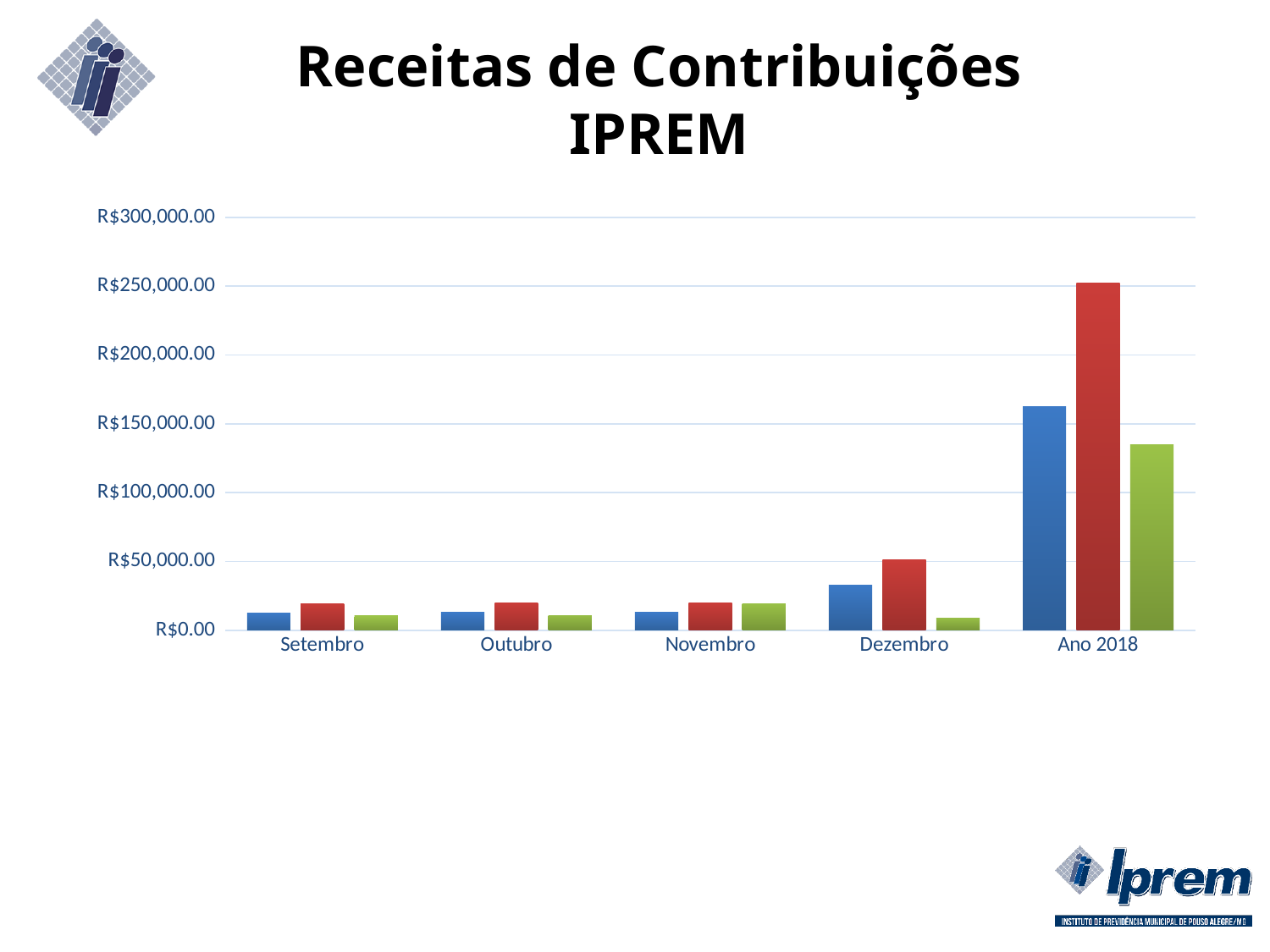
How many bars are plotted for each category in the chart? 3 Which is larger in the Ano 2018 category, the blue bar or the green bar? blue Is the value of the red bar for Ano 2018 greater or less than R$200,000.00? greater Which coloured bar is the shortest in the Dezembro category? green Is the value of the blue bar for Dezembro greater or less than R$50,000.00? less What is the title of the slide containing the chart? Receitas de Contribuições IPREM Which category has the tallest red bar in the chart? Ano 2018 How many categories are shown along the x axis of the chart? 5 What kind of chart is shown on the slide? bar chart Is the value of the green bar for Ano 2018 greater or less than R$150,000.00? less Which is larger, the red bar for Dezembro or the red bar for Novembro? Dezembro Which coloured bar is the tallest in the Ano 2018 category? red